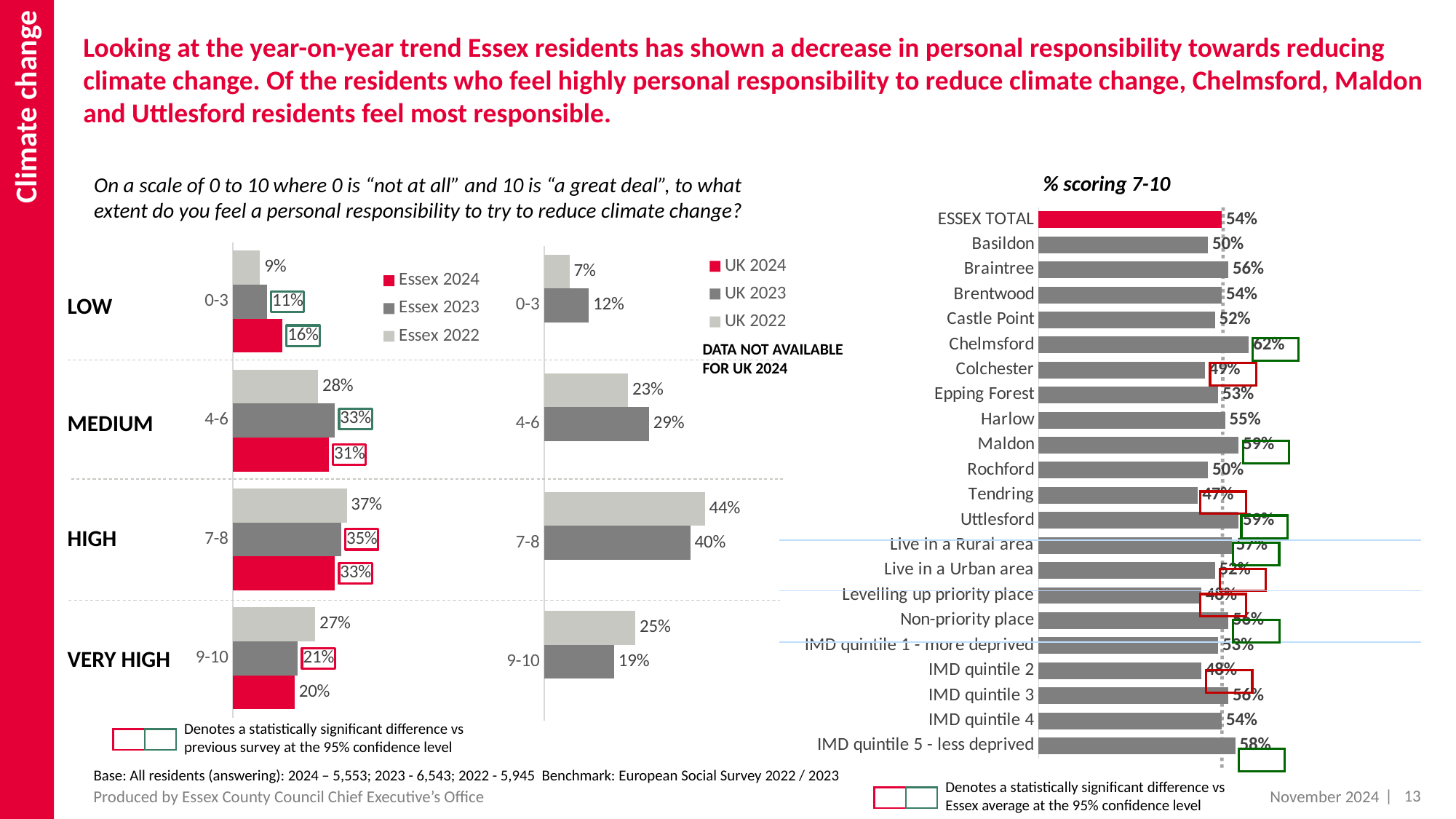
In the middle chart (UK), what is the UK 2023 value for the 4-6 score band? 29% In the left chart (Essex), what is the Essex 2022 value for the 7-8 score band? 37% In the right chart '% scoring 7-10', which district has the highest value? Chelmsford In the middle chart (UK), which is larger for the 7-8 score band: UK 2022 or UK 2023? UK 2022 In the left chart (Essex), what percentage of residents scored 0-3 in Essex 2024? 16% In the right chart '% scoring 7-10', which district has the lowest value? Tendring What type of chart is the right chart '% scoring 7-10'? Bar chart In the middle chart (UK), which series is noted as having data not available? UK 2024 In the right chart '% scoring 7-10', what is the value for Chelmsford? 62% In the right chart '% scoring 7-10', what is the value for ESSEX TOTAL? 54% In the left chart (Essex), how many percentage points higher is the Essex 2022 value than the Essex 2024 value for the 9-10 score band? 7 percentage points How many series does the legend of the left chart (Essex) list? 3